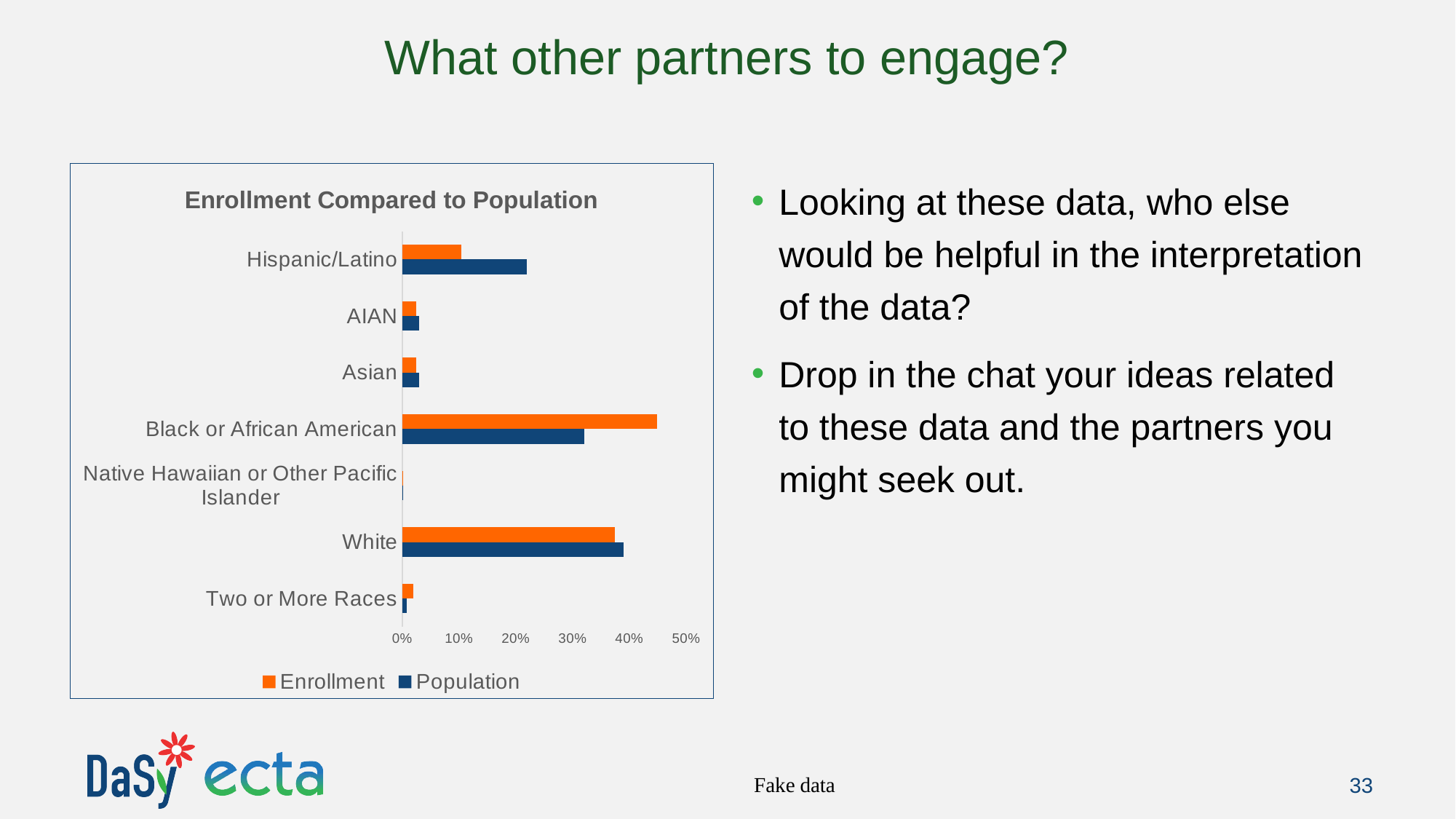
What kind of chart is shown on the slide? Bar chart Which category has the highest Enrollment value? Black or African American How many categories are shown on the chart's vertical axis? 7 For Hispanic/Latino, which is larger: Enrollment or Population? Population Which colour represents the Enrollment series in the chart? Orange What is the title of the chart? Enrollment Compared to Population How many series does the chart's legend list? 2 Which category has the highest Population value? White For Black or African American, which is larger: Enrollment or Population? Enrollment Is the Enrollment value for White greater or less than 40%? less Is the Population value for Hispanic/Latino greater or less than 20%? greater Is the Enrollment value for Black or African American greater or less than 40%? greater